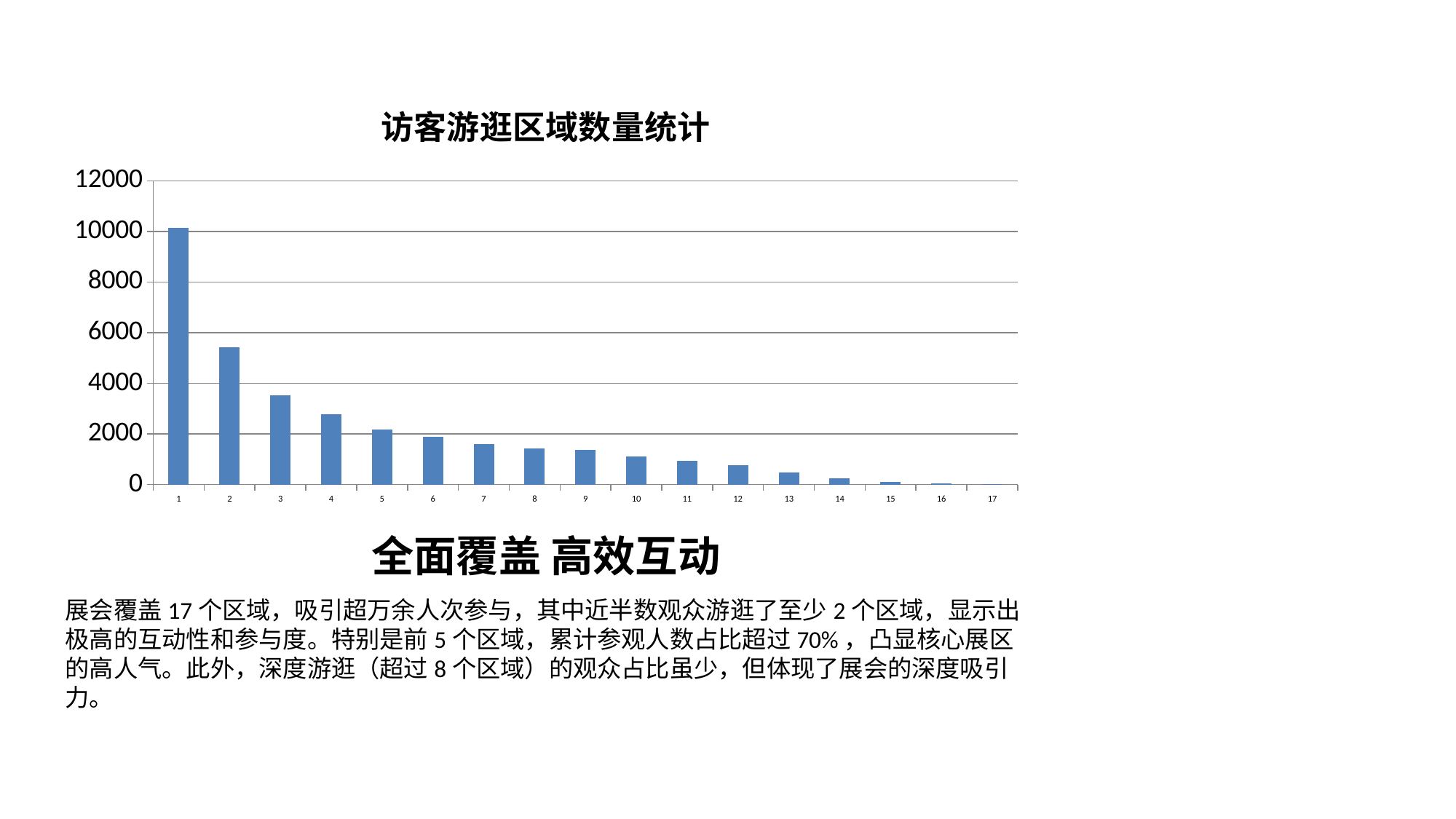
Is the value for category 1 greater or less than 8000? greater Is the value for category 4 greater or less than 2000? greater How many categories are shown on the x axis of the chart? 17 What kind of chart is shown on the slide? bar chart Is the value for category 13 greater or less than 1000? less What is the title of the chart? 访客游逛区域数量统计 Which category has the lowest value in the chart? 17 Which category has the highest value in the chart? 1 Do the values rise or fall as you move from category 1 to category 17 along the x axis? fall Which has the larger value, category 2 or category 3? 2